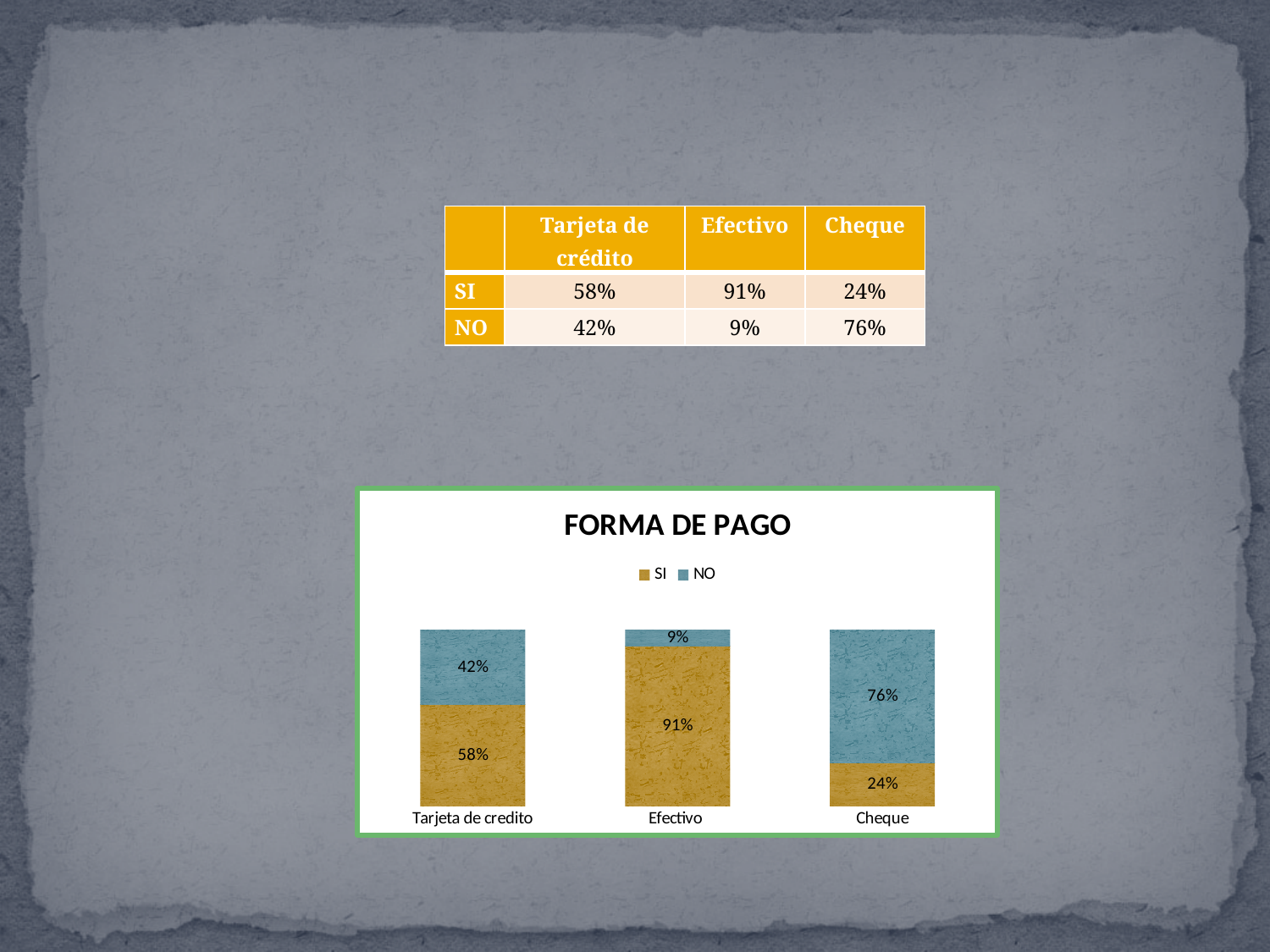
What is the SI value for Tarjeta de credito? 58% Which category has the highest SI value? Efectivo Which is larger, the SI value for Tarjeta de credito or the SI value for Cheque? Tarjeta de credito What is the difference between the NO value for Cheque and the NO value for Tarjeta de credito? 34% How many series does the chart legend list? 2 Which category has the lowest NO value? Efectivo What is the NO value for Cheque? 76% What is the SI value for Efectivo? 91% What is the total of the stacked bar for Cheque? 100% What type of chart is shown on the slide? stacked bar chart How many categories are shown on the x axis of the chart? 3 What is the title of the chart? FORMA DE PAGO